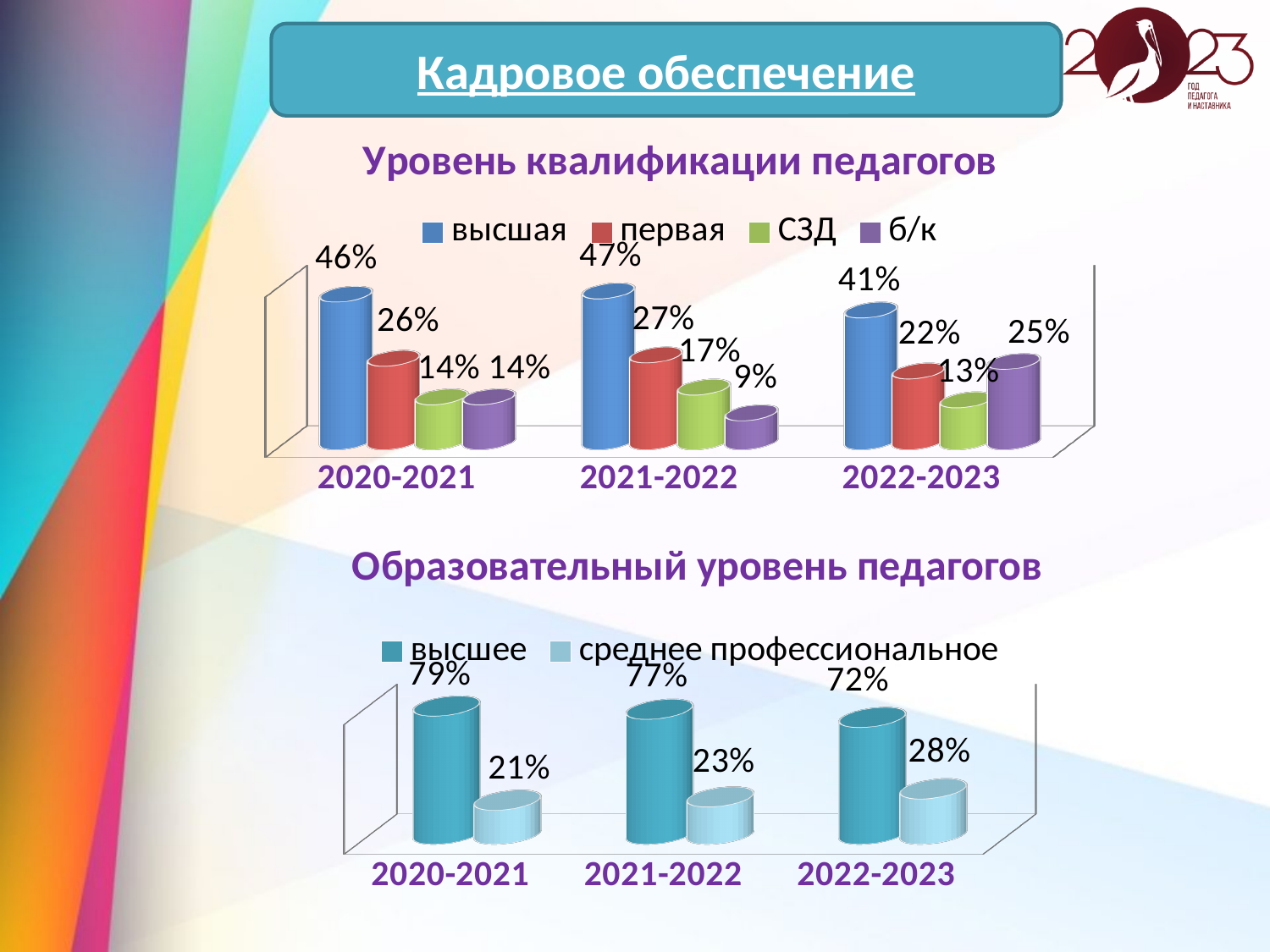
In the chart 'Уровень квалификации педагогов', does the value for 'высшая' rise or fall from 2021-2022 to 2022-2023? fall What kind of chart is 'Образовательный уровень педагогов'? bar chart In the chart 'Образовательный уровень педагогов', what is the value for 'среднее профессиональное' in 2021-2022? 23% In the chart 'Образовательный уровень педагогов', is the value for 'высшее' in 2020-2021 larger or the value for 'высшее' in 2022-2023? 2020-2021 In the chart 'Образовательный уровень педагогов', what is the difference between 'высшее' and 'среднее профессиональное' in 2022-2023? 44% In the chart 'Уровень квалификации педагогов', how many series does the legend list? 4 In the chart 'Уровень квалификации педагогов', what is the difference between 'высшая' and 'первая' in 2020-2021? 20% In the chart 'Образовательный уровень педагогов', how many year categories are shown on the x axis? 3 In the chart 'Уровень квалификации педагогов', what is the value for 'высшая' in 2021-2022? 47% In the chart 'Уровень квалификации педагогов', which year has the lowest value for 'б/к'? 2021-2022 In the chart 'Уровень квалификации педагогов', what is the value for 'б/к' in 2022-2023? 25% In the chart 'Образовательный уровень педагогов', which year has the highest value for 'высшее'? 2020-2021